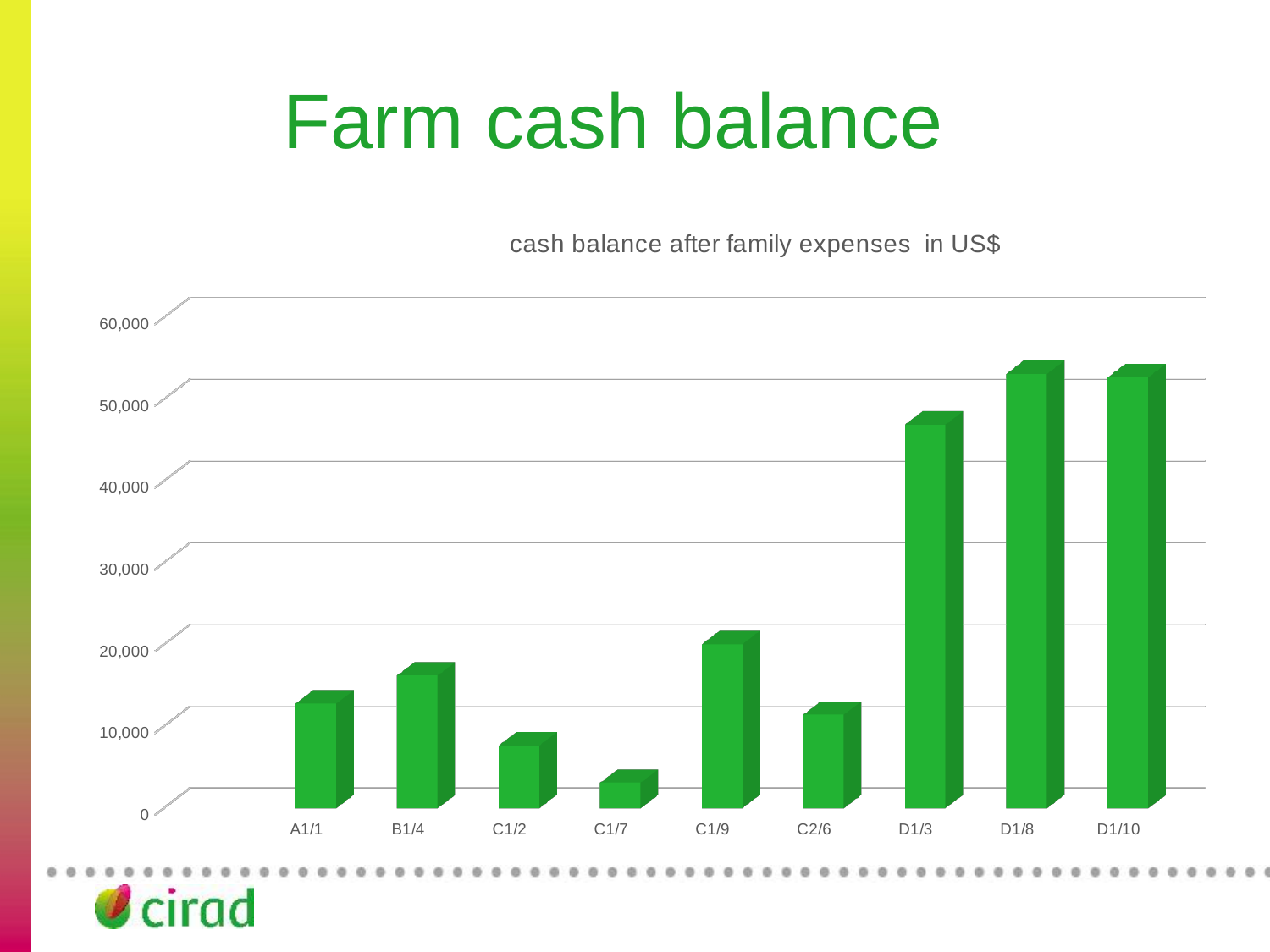
What type of chart is shown on the slide? bar chart Is the value for D1/8 greater or less than 50,000? greater What colour are the bars in the chart? green Is the value for B1/4 greater or less than 10,000? greater Is the value for C1/2 greater or less than 10,000? less How many categories are plotted on the x axis of the chart? 9 Which category has the lowest cash balance in the chart? C1/7 Which has a larger cash balance, C1/9 or D1/3? D1/3 Which has a larger cash balance, A1/1 or B1/4? B1/4 What is the title of the chart? cash balance after family expenses in US$